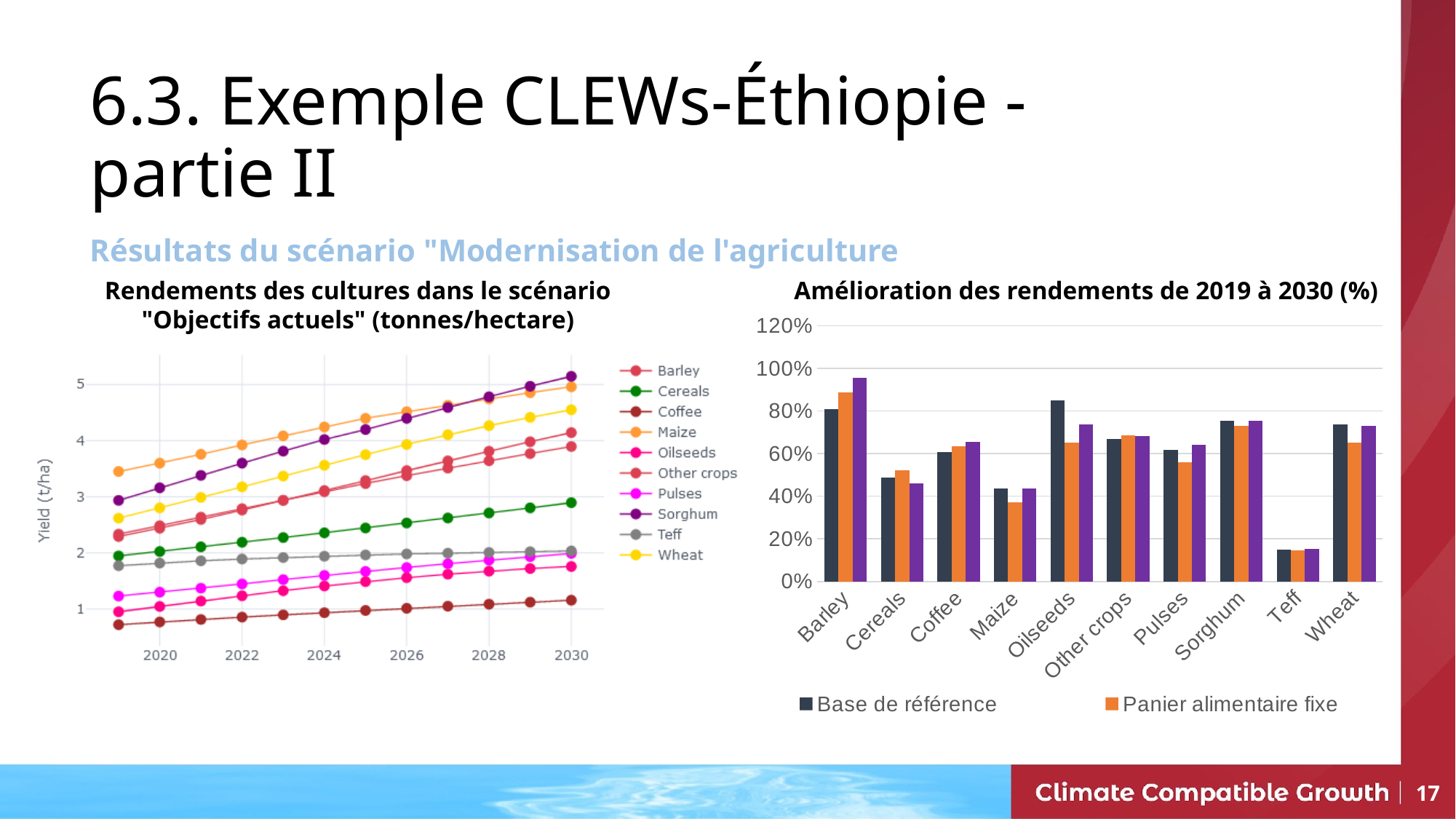
In the left chart (crop yields), is the yield for Sorghum in 2030 greater or less than 5 t/ha? greater In the left chart (crop yields), do the yields rise or fall from 2019 to 2030? rise In the left chart (crop yields), which crop has the highest yield in 2030? Sorghum What kind of chart is the right chart, "Amélioration des rendements de 2019 à 2030 (%)"? bar chart What kind of chart is the left chart, "Rendements des cultures dans le scénario 'Objectifs actuels'"? line chart In the left chart (crop yields), which crop has the lowest yield across the whole period? Coffee In the right chart (Amélioration des rendements), how many crop categories are shown on the x axis? 10 In the left chart (crop yields), is the yield for Coffee in 2020 greater or less than 1 t/ha? less In the right chart (Amélioration des rendements), is the "Base de référence" value for Teff greater or less than 20%? less In the right chart (Amélioration des rendements), for Oilseeds, which is larger: "Base de référence" or "Panier alimentaire fixe"? Base de référence In the left chart (crop yields), how many series does the legend list? 10 In the right chart (Amélioration des rendements), which crop has the lowest improvement for "Base de référence"? Teff